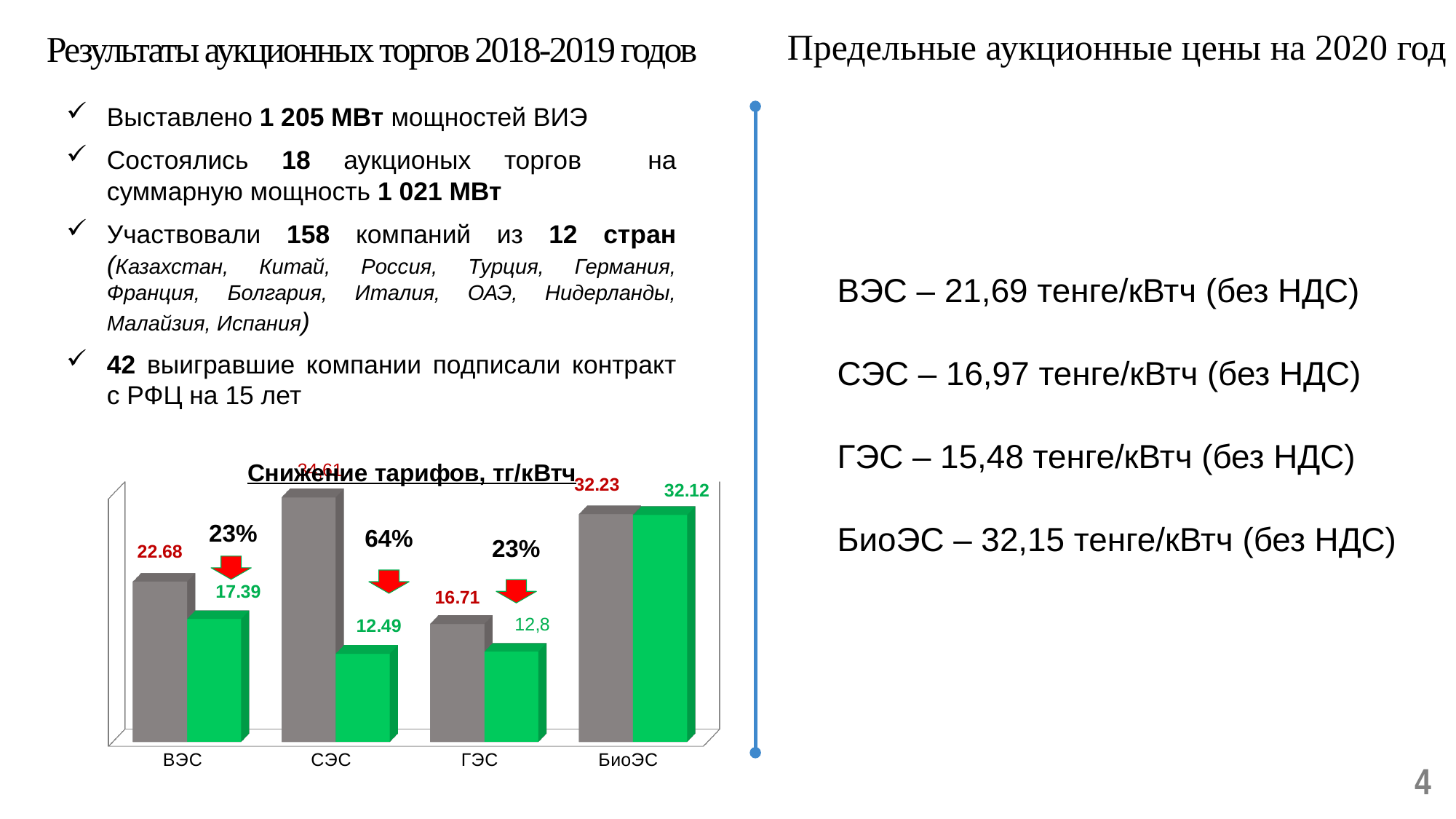
In the chart 'Снижение тарифов, тг/кВтч', what is the value of the grey bar for ГЭС? 16.71 In the chart 'Снижение тарифов, тг/кВтч', what is the value of the green bar for БиоЭС? 32.12 In the chart 'Снижение тарифов, тг/кВтч', what is the difference between the grey and green bars for ВЭС? 5.29 In the chart 'Снижение тарифов, тг/кВтч', which category has the lowest green bar? СЭС In the chart 'Снижение тарифов, тг/кВтч', what is the value of the grey bar for ВЭС? 22.68 What type of chart is 'Снижение тарифов, тг/кВтч'? bar chart In the chart 'Снижение тарифов, тг/кВтч', what is the value of the grey bar for БиоЭС? 32.23 How many categories are shown on the x axis of the chart 'Снижение тарифов, тг/кВтч'? 4 In the chart 'Снижение тарифов, тг/кВтч', what percentage reduction is shown above the СЭС bars? 64% In the chart 'Снижение тарифов, тг/кВтч', what is the value of the green bar for СЭС? 12.49 In the chart 'Снижение тарифов, тг/кВтч', what is the value of the green bar for ВЭС? 17.39 In the chart 'Снижение тарифов, тг/кВтч', which category has the highest green bar? БиоЭС